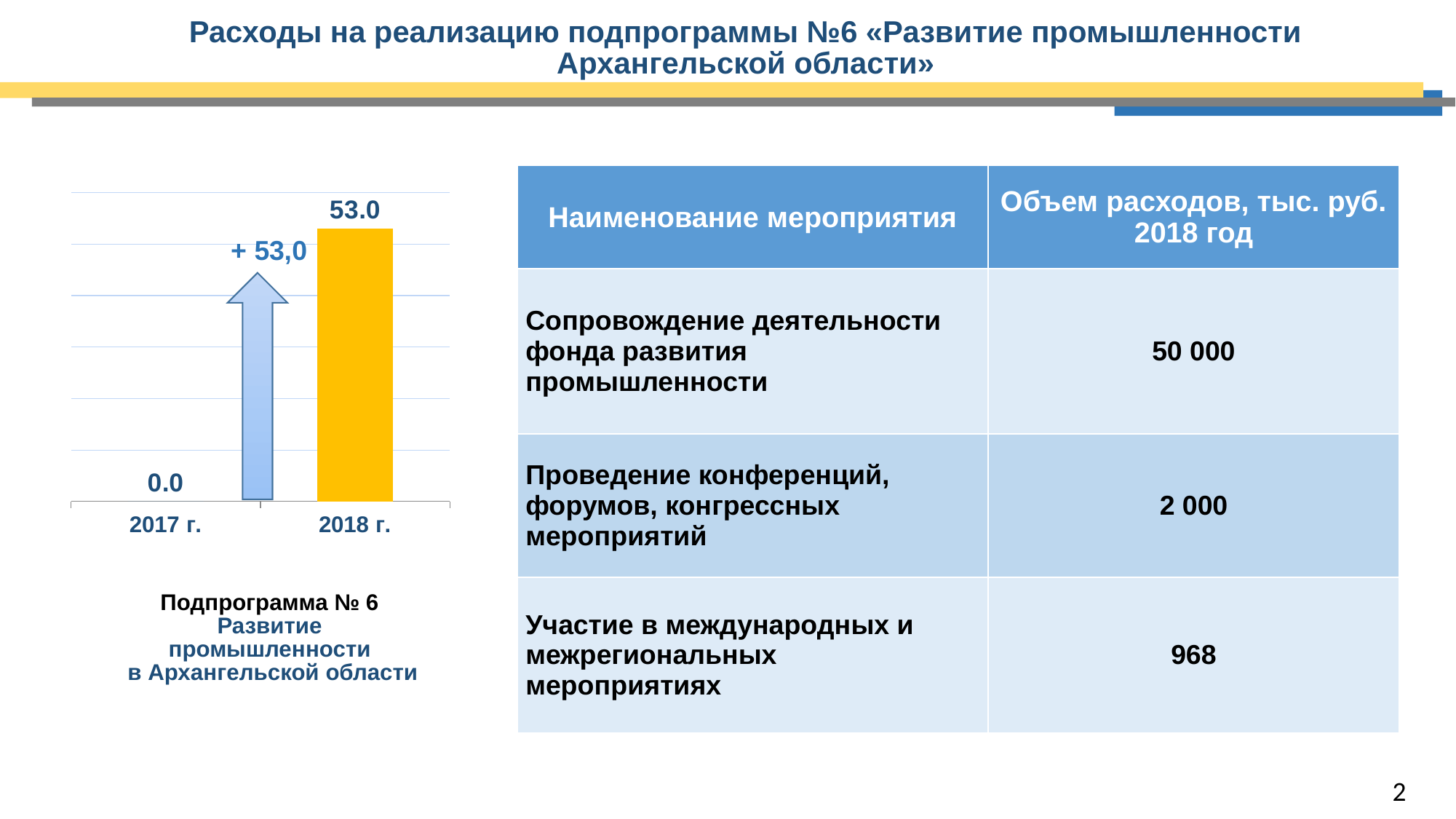
What change is indicated by the arrow annotation in the bar chart? + 53,0 Which year has the lowest value in the bar chart? 2017 г. Do the values in the bar chart rise or fall from 2017 г. to 2018 г.? rise What colour is the bar for 2018 г. in the chart? yellow How many categories (years) are shown on the x axis of the bar chart? 2 What is the difference between the 2018 г. and 2017 г. values in the bar chart? 53.0 Is the value for 2018 г. larger or smaller than the value for 2017 г.? larger What kind of chart is shown on the left of the slide? bar chart What is the value shown for 2017 г. in the bar chart? 0.0 Which year has the higher value in the bar chart? 2018 г. What is the value shown for 2018 г. in the bar chart? 53.0